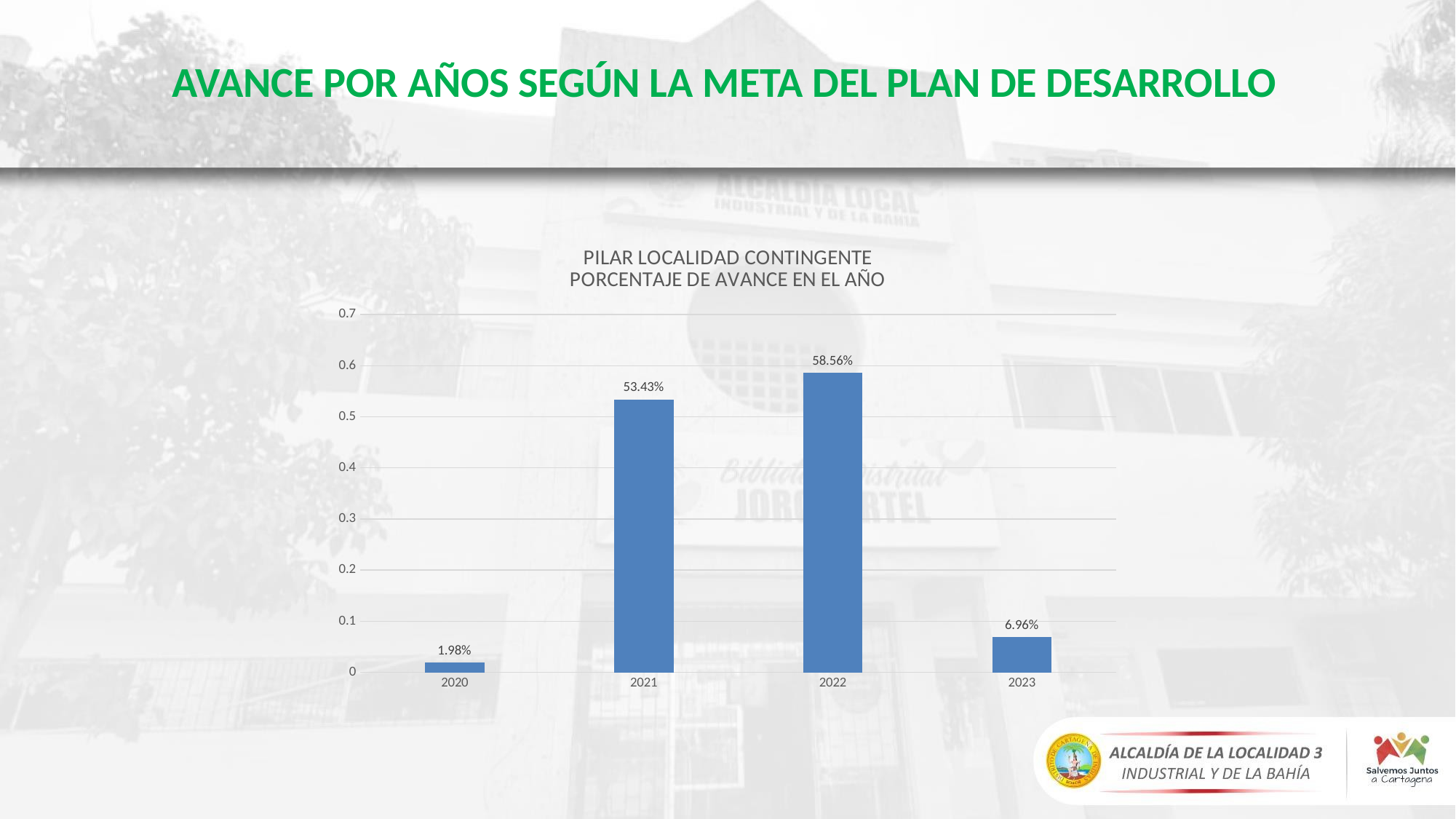
What is the value for 2021? 53.43% Do the values rise or fall from 2022 to 2023? Fall Which year has the highest value? 2022 What kind of chart is shown? Bar chart How many years are shown on the x axis? 4 What is the value for 2020? 1.98% What is the difference between the values for 2022 and 2021? 5.13% What is the value for 2023? 6.96% Which is larger, the value for 2023 or the value for 2020? 2023 Is the value for 2022 greater or less than 0.5 on the axis? greater What is the title of the chart? PILAR LOCALIDAD CONTINGENTE PORCENTAJE DE AVANCE EN EL AÑO Which year has the lowest value? 2020